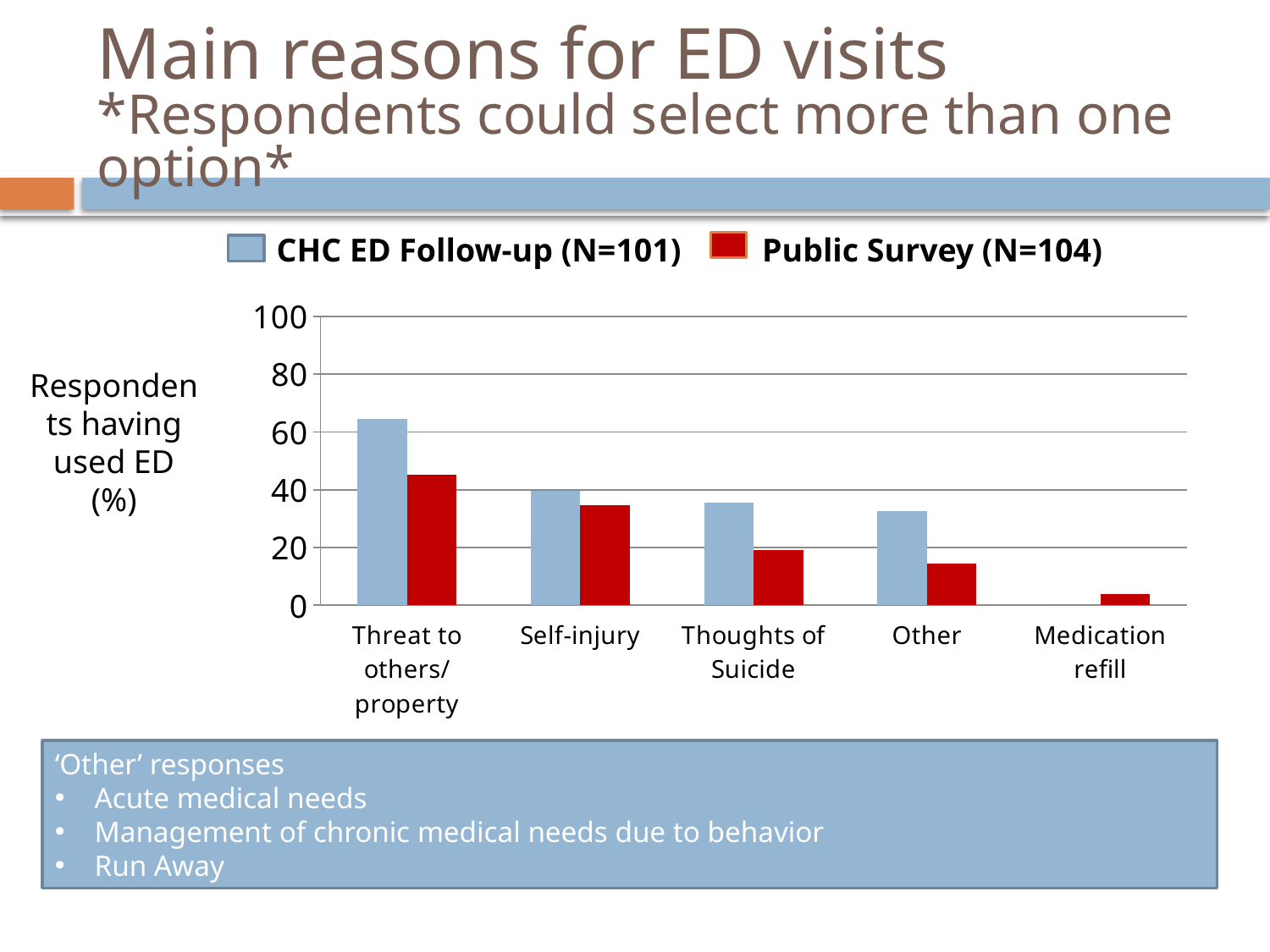
Do the CHC ED Follow-up values rise or fall from left to right across the categories? fall How many series does the legend list? 2 For Threat to others/property, which series has the larger value: CHC ED Follow-up or Public Survey? CHC ED Follow-up (N=101) Which category has the highest value for Public Survey (N=104)? Threat to others/property Is the Public Survey value for Other greater or less than 20? less How many categories are shown on the x axis? 5 Is the CHC ED Follow-up value for Threat to others/property greater or less than 60? greater Which category has the highest value for CHC ED Follow-up (N=101)? Threat to others/property What kind of chart is shown on the slide? bar chart Which category has the lowest value for Public Survey (N=104)? Medication refill What is the label of the y axis? Respondents having used ED (%) For Thoughts of Suicide, which series has the larger value: CHC ED Follow-up or Public Survey? CHC ED Follow-up (N=101)